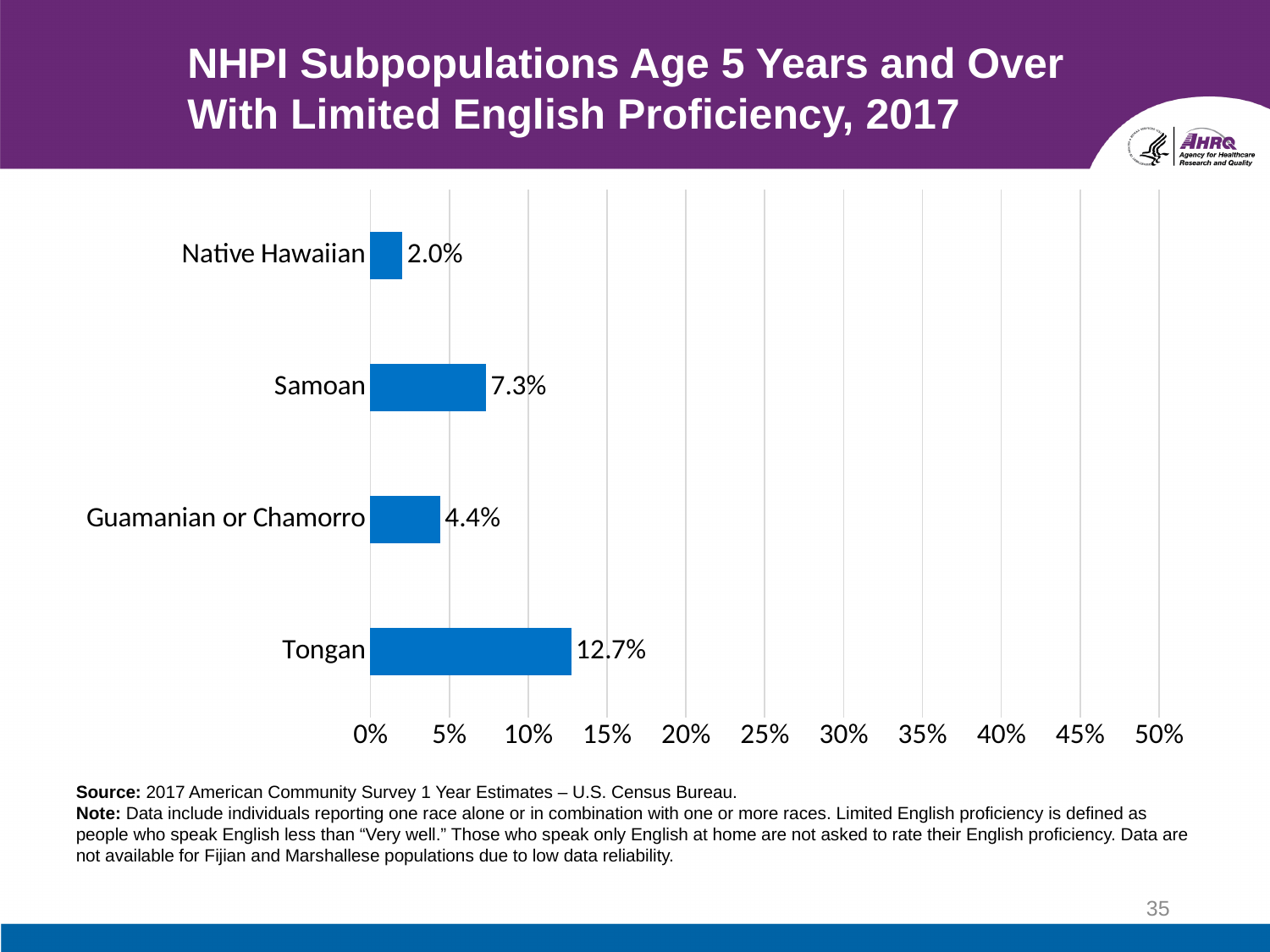
What is the value for Guamanian or Chamorro? 4.4% Which subpopulation has the highest percentage with limited English proficiency? Tongan Which subpopulation has the lowest percentage with limited English proficiency? Native Hawaiian Which is larger, the value for Samoan or the value for Guamanian or Chamorro? Samoan What is the difference between the values for Guamanian or Chamorro and Native Hawaiian? 2.4% What is the value for Samoan? 7.3% What is the difference between the values for Tongan and Samoan? 5.4% How many subpopulations are shown in the chart? 4 What is the value for Tongan? 12.7% What kind of chart is shown on the slide? Bar chart Is the value for Tongan greater or less than 10%? greater What is the value for Native Hawaiian? 2.0%